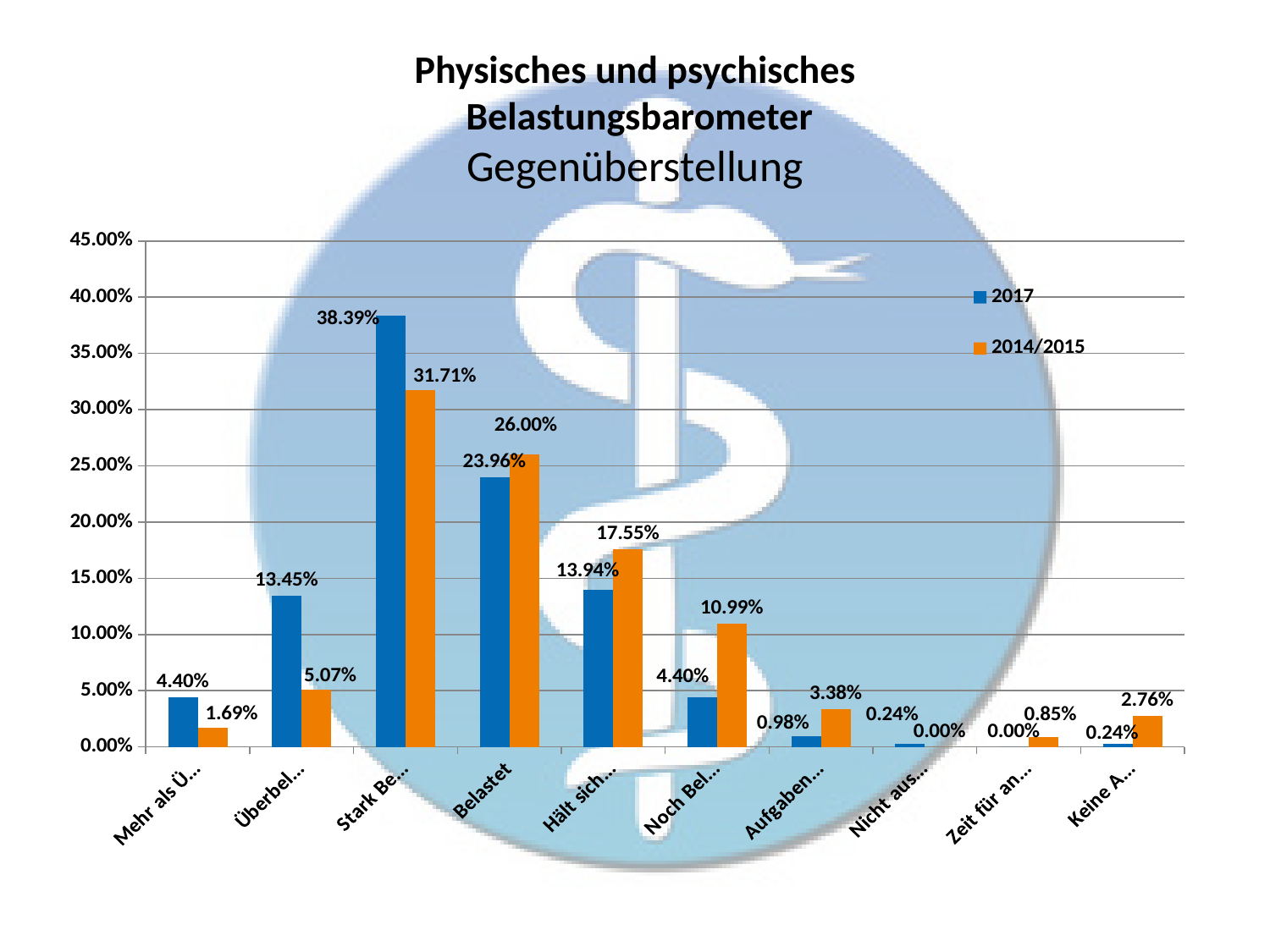
Which two series are listed in the legend? 2017 and 2014/2015 What is the difference between the highest 2017 value (38.39%) and the highest 2014/2015 value (31.71%)? 6.68% What is the difference between the 2014/2015 and 2017 values for Belastet? 2.04% How many series does the legend list? 2 Is the 2017 value for Belastet greater or less than 25.00%? less What is the 2017 value for Belastet? 23.96% How many categories are shown on the x axis? 10 What is the 2014/2015 value for Belastet? 26.00% What is the highest value shown for the 2014/2015 series? 31.71% What is the highest value shown for the 2017 series? 38.39% Which series has the larger value for Belastet, 2017 or 2014/2015? 2014/2015 What type of chart is shown on the slide? bar chart